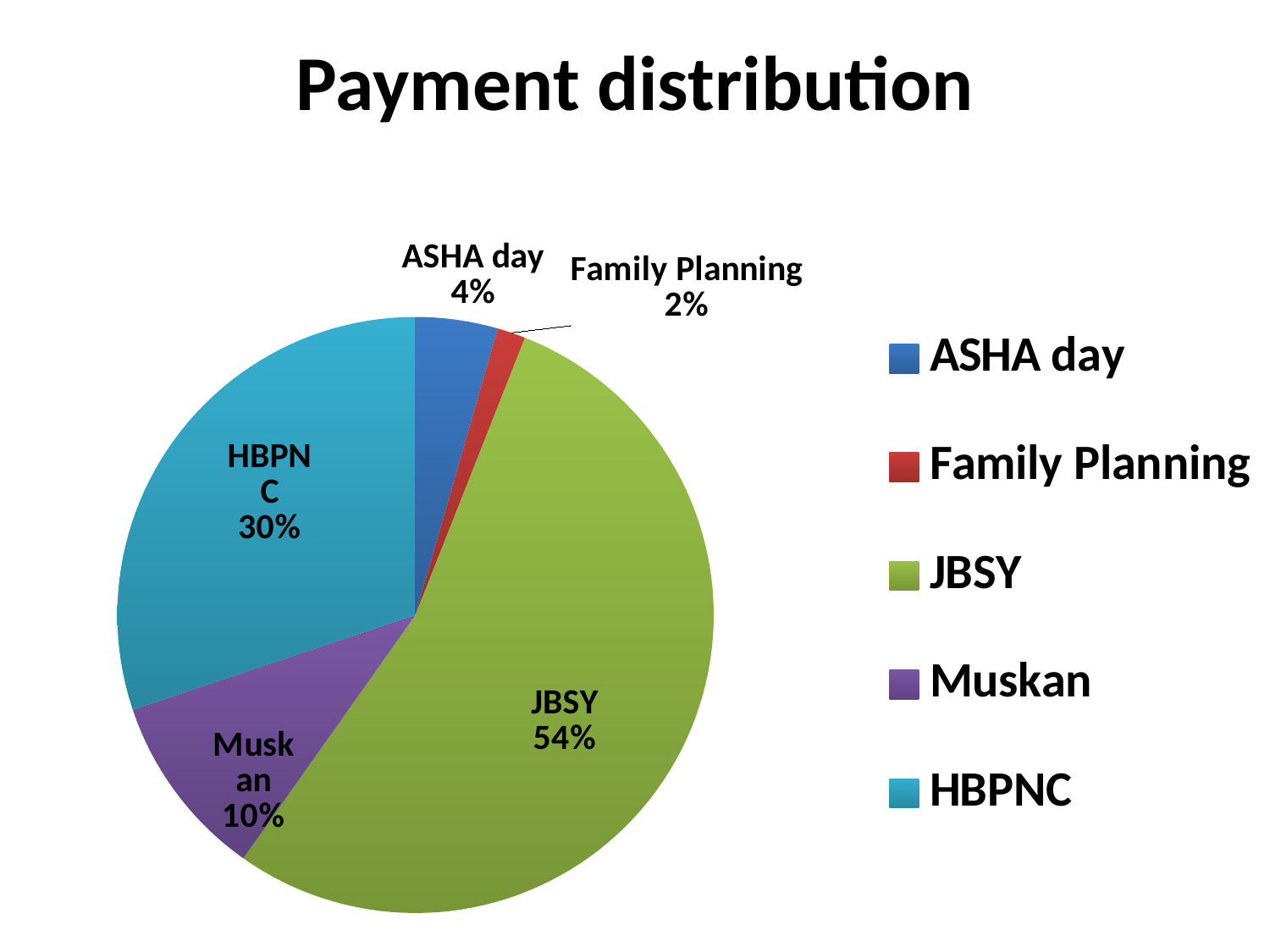
What percentage is shown for ASHA day? 4% What share of the pie does JBSY account for? 54% What percentage is shown for Muskan? 10% Which category has the largest share of the pie? JBSY How many categories are shown in the pie chart? 5 What kind of chart is shown on the slide? Pie chart What percentage is shown for Family Planning? 2% What is the title of the chart? Payment distribution What is the difference in percentage points between JBSY and HBPNC? 24 What percentage is shown for HBPNC? 30% Which is larger, the share for Muskan or the share for ASHA day? Muskan Which category has the smallest share of the pie? Family Planning